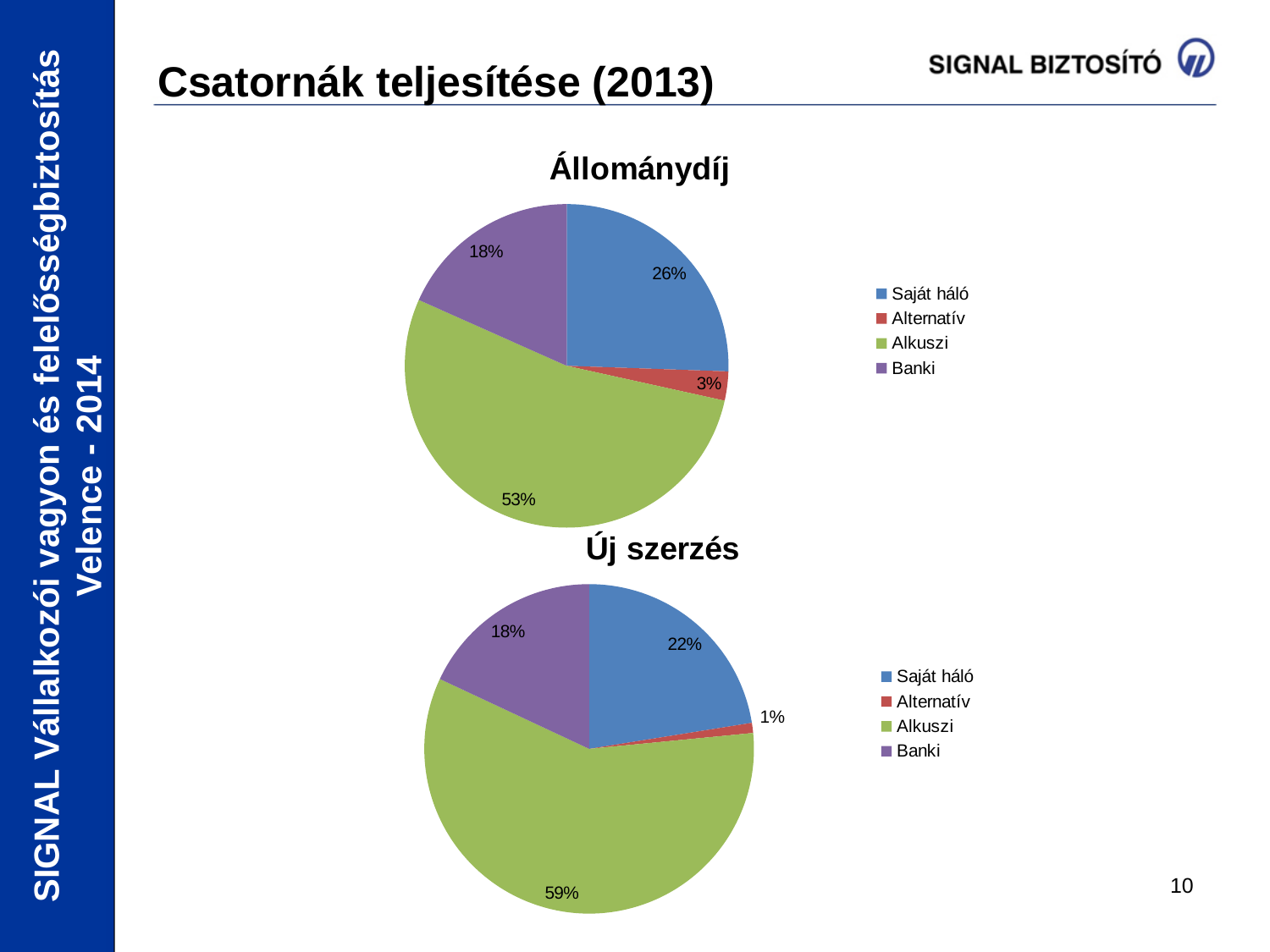
In the Állománydíj chart, what share does Alkuszi have? 53% In the Új szerzés chart, what share does Alkuszi have? 59% In the Állománydíj chart, what share does Saját háló have? 26% In the Állománydíj chart, which category has the smallest share? Alternatív In the Állománydíj chart, which category has the largest share? Alkuszi In the Állománydíj chart, which colour represents Banki? Purple In the Állománydíj chart, what is the difference between the Saját háló and Banki shares? 8% In the Új szerzés chart, which is larger, Saját háló or Banki? Saját háló How many categories does the legend of the Új szerzés chart list? 4 What kind of chart is the Állománydíj chart? Pie chart In the Új szerzés chart, what is the difference between the Alkuszi and Saját háló shares? 37%